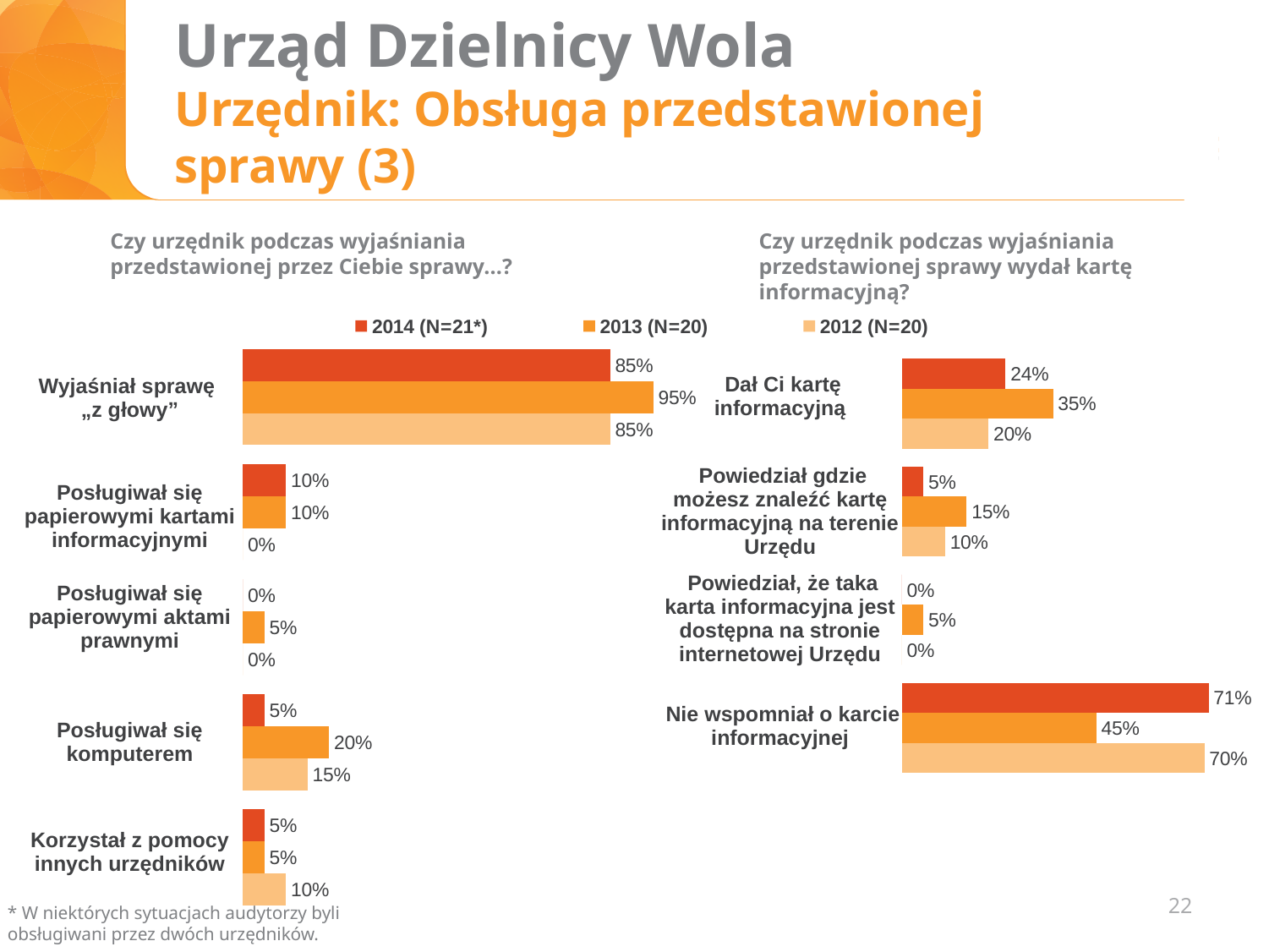
In the right chart, what is the difference between the 2014 (N=21*) and 2012 (N=20) values for "Nie wspomniał o karcie informacyjnej"? 1% In the left chart, which category has the lowest 2013 (N=20) value? Posługiwał się papierowymi aktami prawnymi and Korzystał z pomocy innych urzędników (both 5%) In the left chart, what is the 2014 (N=21*) value for "Posługiwał się komputerem"? 5% In the left chart, which is larger for "Posługiwał się komputerem": the 2013 (N=20) value or the 2012 (N=20) value? 2013 (N=20) In the right chart ("Czy urzędnik podczas wyjaśniania przedstawionej sprawy wydał kartę informacyjną?"), what is the 2014 (N=21*) value for "Nie wspomniał o karcie informacyjnej"? 71% In the right chart, what is the difference between the 2013 (N=20) and 2014 (N=21*) values for "Dał Ci kartę informacyjną"? 11% In the left chart ("Czy urzędnik podczas wyjaśniania przedstawionej przez Ciebie sprawy...?"), what is the 2013 (N=20) value for "Wyjaśniał sprawę „z głowy”"? 95% In the right chart, what is the 2012 (N=20) value for "Dał Ci kartę informacyjną"? 20% What type of chart is the right chart? Bar chart In the right chart, which category has the highest 2013 (N=20) value? Nie wspomniał o karcie informacyjnej How many series does the legend list? 3 How many categories does the left chart show? 5